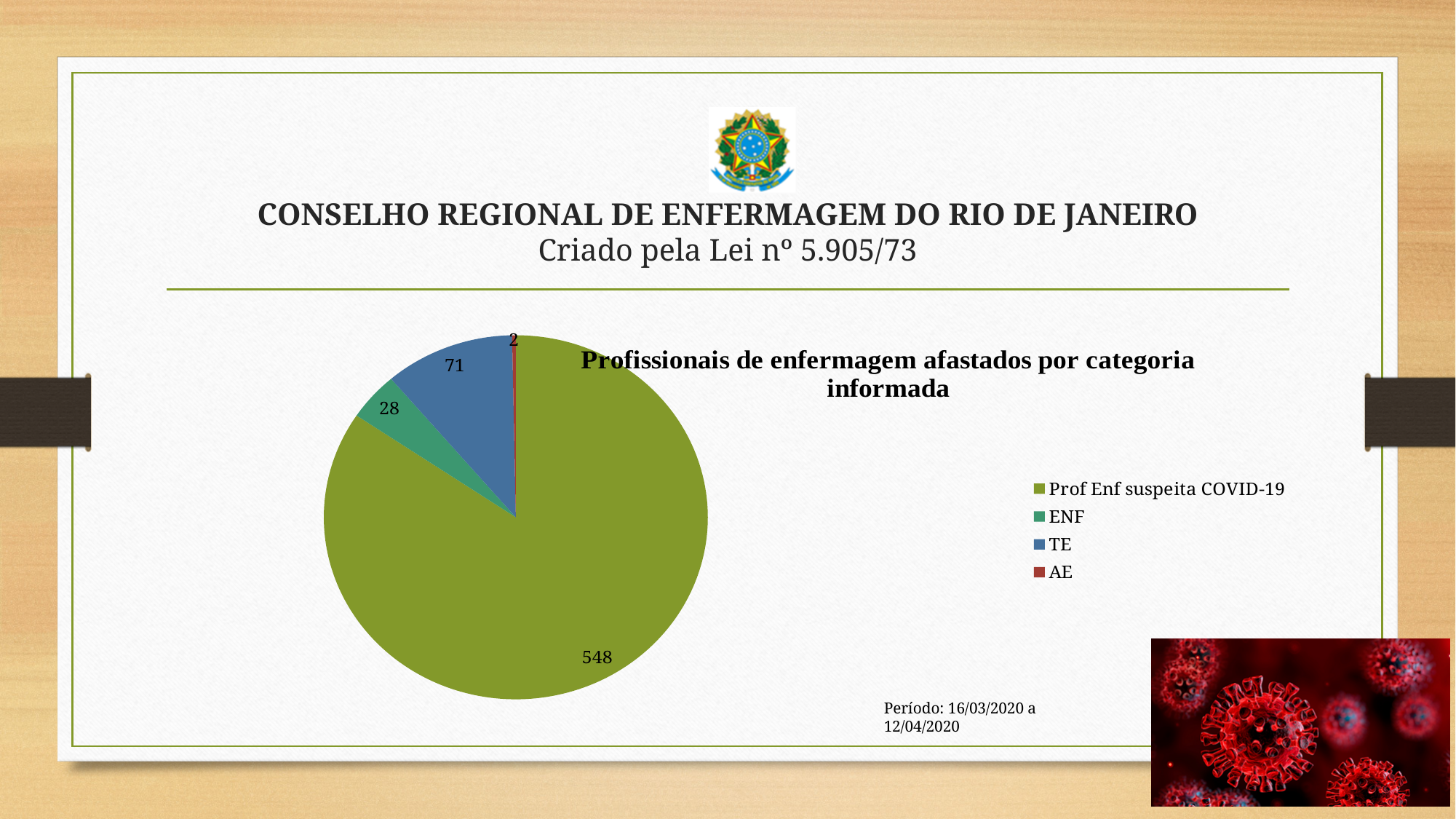
What is the difference between the values for TE and ENF? 43 Which category has the largest slice of the pie? Prof Enf suspeita COVID-19 What kind of chart is shown on the slide? pie chart What is the total of all the values shown in the pie chart? 649 What is the value for AE? 2 What is the value for Prof Enf suspeita COVID-19? 548 What is the title of the chart? Profissionais de enfermagem afastados por categoria informada Which is larger, the value for TE or the value for ENF? TE What is the value for ENF? 28 Which category has the smallest slice of the pie? AE What is the value for TE? 71 How many categories does the pie chart show? 4